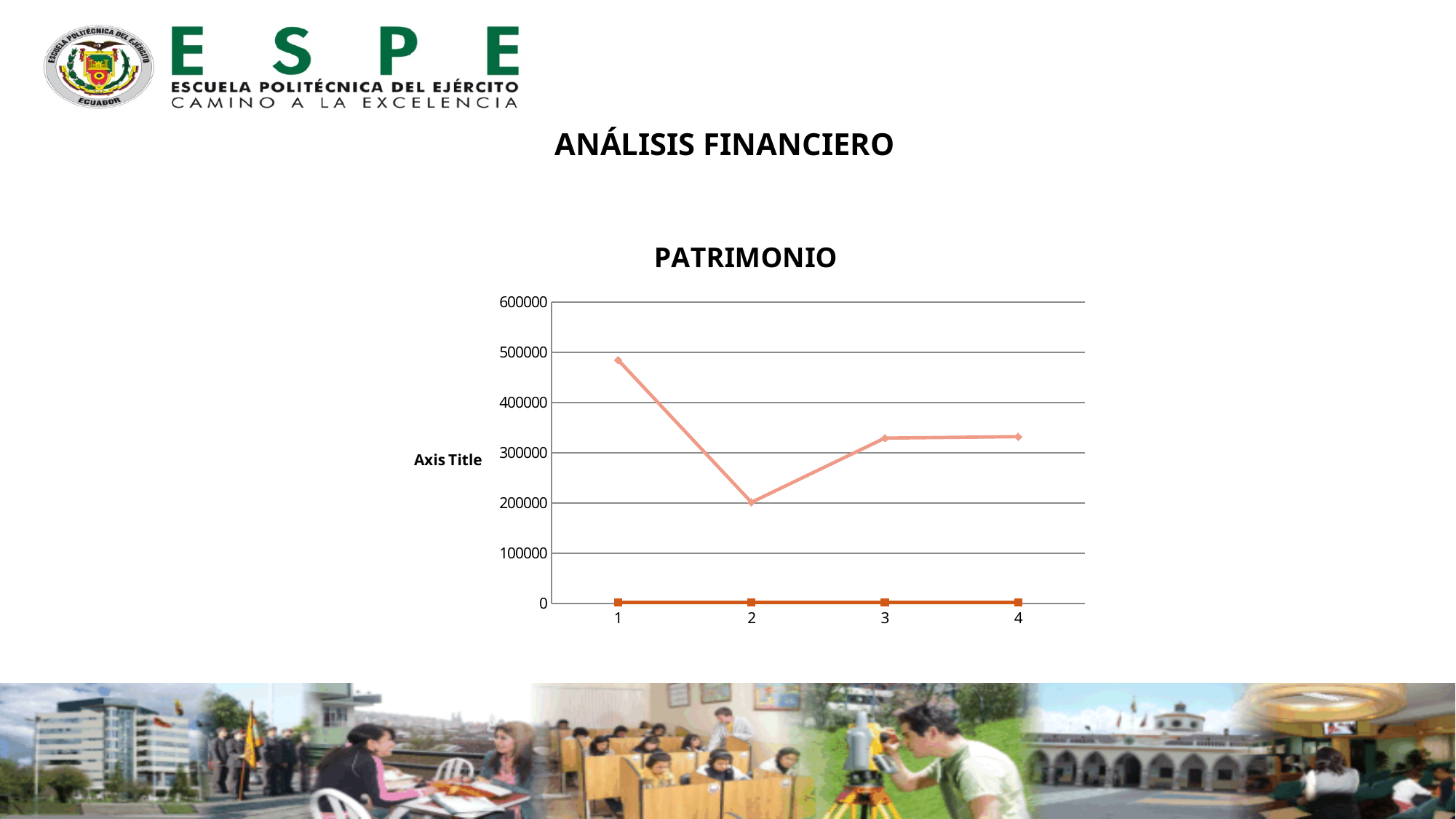
Is the value for category 1 on the upper line greater or less than 500000? less What is the title of the chart? PATRIMONIO Is the value for category 1 on the upper line greater or less than 400000? greater Is the value for category 4 on the upper line greater or less than 400000? less On the upper line, which is larger: the value for category 1 or the value for category 2? category 1 What kind of chart is shown on the slide? line chart How many categories are shown on the x axis of the chart? 4 Does the upper line rise or fall from category 2 to category 3? rise Which category has the lowest value on the upper (salmon) line? 2 Which category has the highest value on the upper (salmon) line? 1 Does the upper line rise or fall from category 1 to category 2? fall